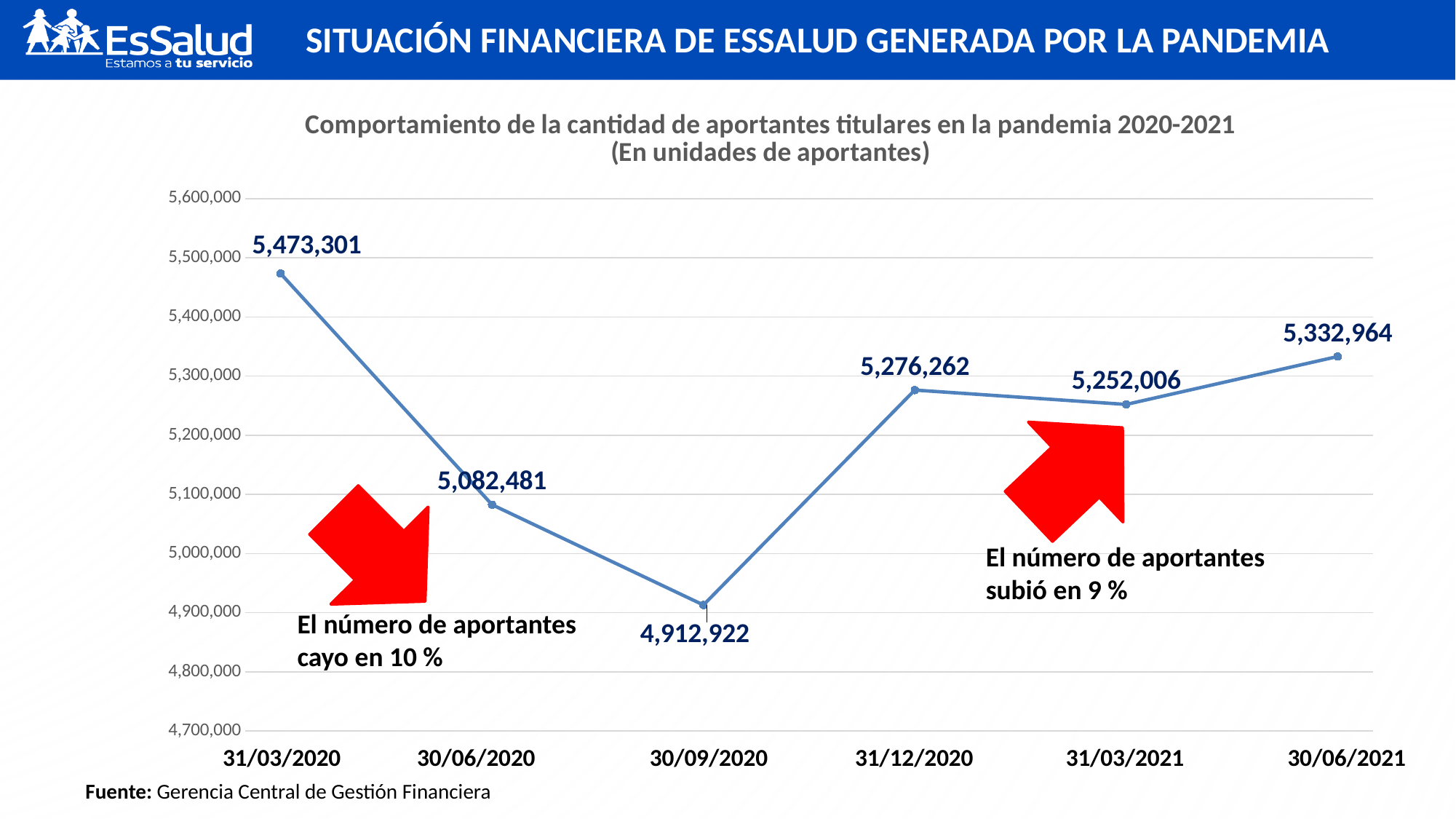
Do the values rise or fall from 30/09/2020 to 31/12/2020? rise Which is larger, the value for 31/12/2020 or the value for 31/03/2021? 31/12/2020 What is the number of aportantes on 31/03/2020? 5,473,301 Which date has the lowest number of aportantes? 30/09/2020 What is the number of aportantes on 30/06/2021? 5,332,964 What kind of chart is shown on the slide? line chart What is the number of aportantes on 30/09/2020? 4,912,922 Is the value for 30/09/2020 greater or less than 5,000,000? less What is the difference between the values for 31/03/2020 and 30/06/2020? 390,820 How many dates are plotted on the chart? 6 What is the difference between the values for 30/06/2021 and 31/03/2021? 80,958 Which date has the highest number of aportantes? 31/03/2020